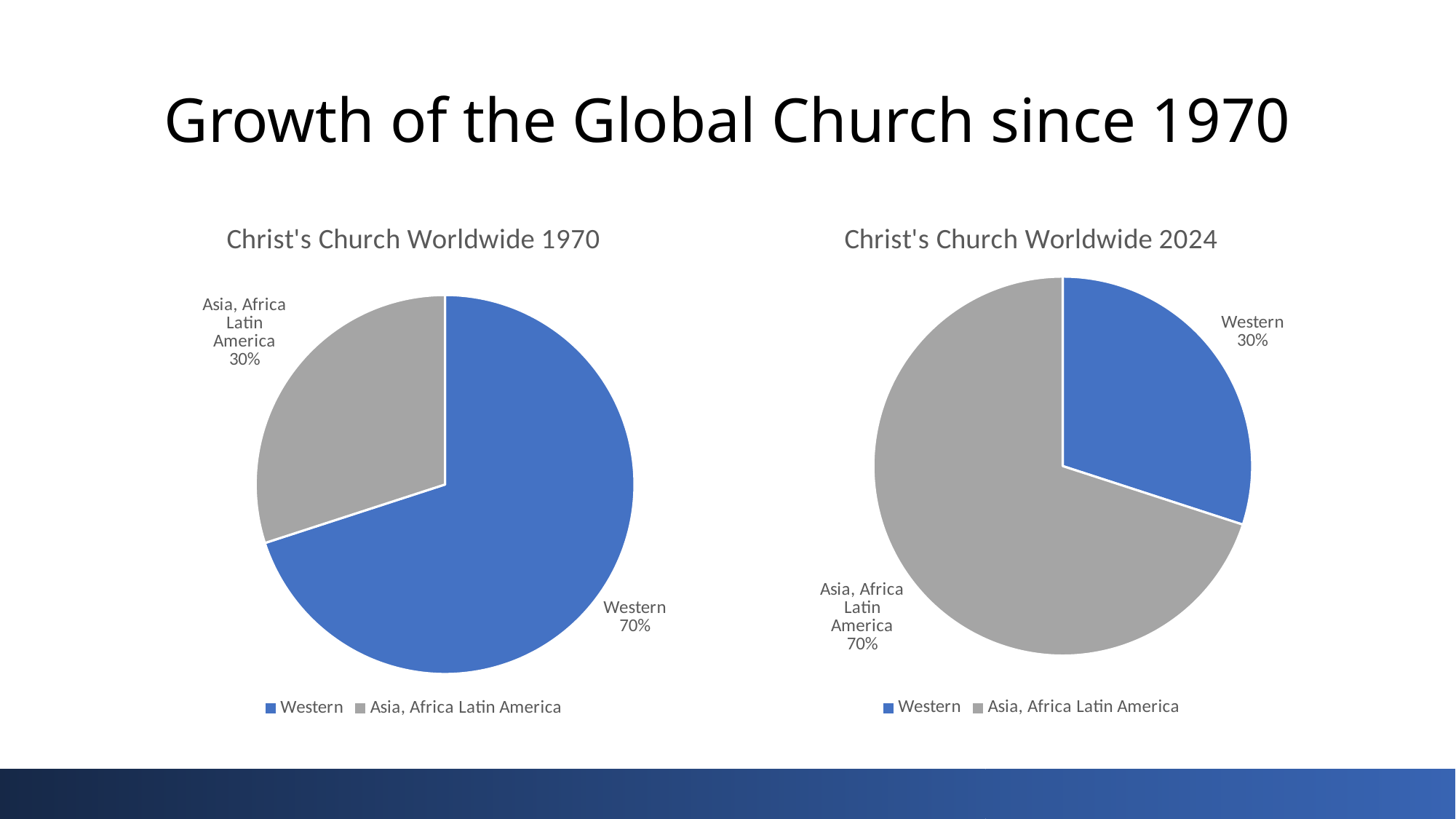
In the 'Christ's Church Worldwide 1970' chart, what share does the Western slice have? 70% In the 'Christ's Church Worldwide 1970' chart, what colour is the Western slice? Blue In the 'Christ's Church Worldwide 2024' chart, what share does the Asia, Africa Latin America slice have? 70% In the 'Christ's Church Worldwide 1970' chart, which slice is the largest? Western In the 'Christ's Church Worldwide 2024' chart, what share does the Western slice have? 30% In the 'Christ's Church Worldwide 2024' chart, which slice is the smallest? Western What kind of chart is 'Christ's Church Worldwide 2024'? Pie chart How many slices does the 'Christ's Church Worldwide 1970' chart have? 2 In the 'Christ's Church Worldwide 2024' chart, which is larger: Western or Asia, Africa Latin America? Asia, Africa Latin America In the 'Christ's Church Worldwide 1970' chart, what is the difference between the Western share and the Asia, Africa Latin America share? 40% How many entries does the legend of the 'Christ's Church Worldwide 2024' chart list? 2